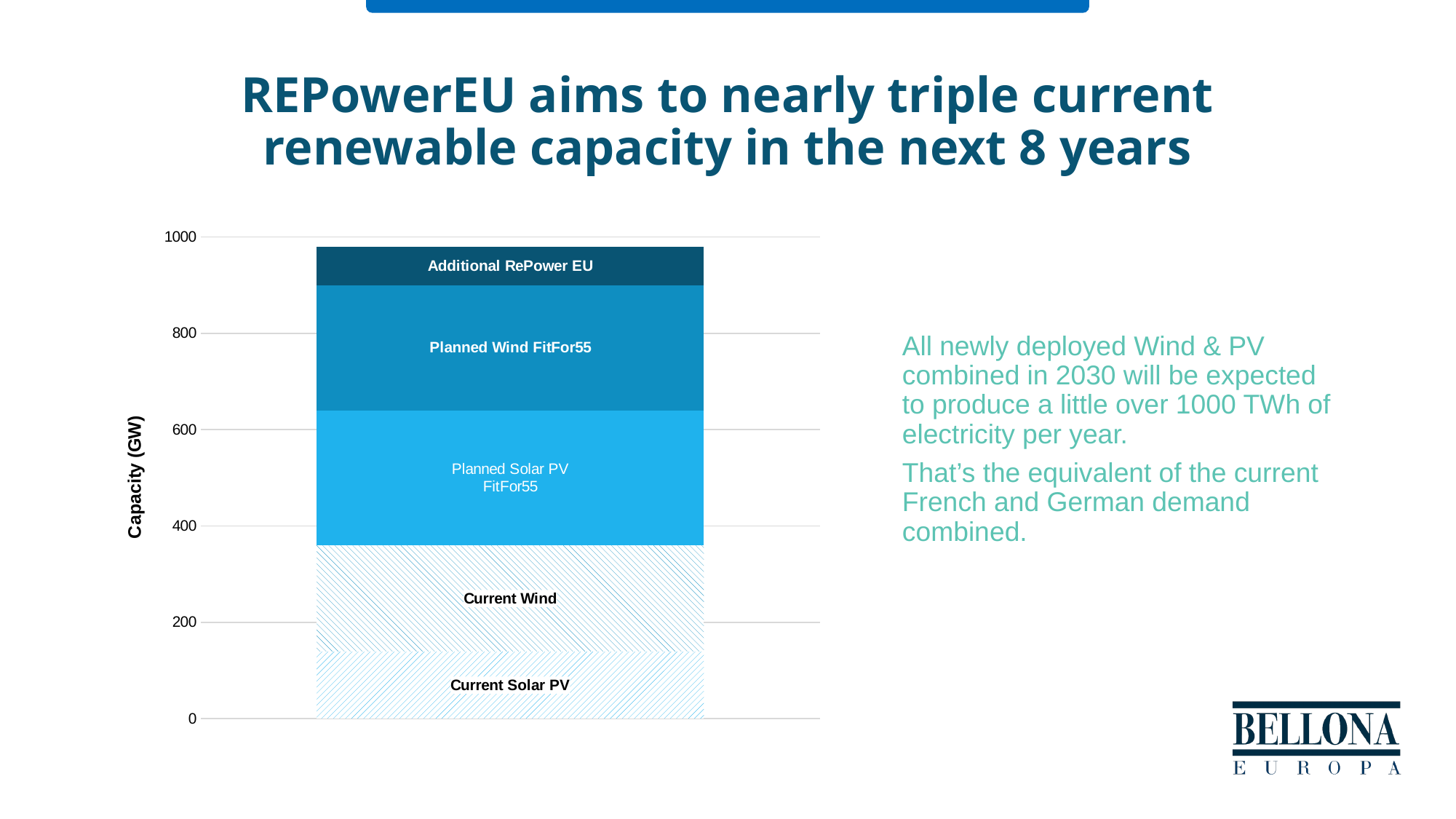
Which is larger, the Current Wind segment or the Current Solar PV segment? Current Wind Which is larger, the Planned Solar PV FitFor55 segment or the Additional RePower EU segment? Planned Solar PV FitFor55 What is the label of the vertical axis? Capacity (GW) Is the combined capacity of Current Solar PV and Current Wind greater or less than 400? less Which segment is at the top of the stacked bar? Additional RePower EU What kind of chart is shown on the slide? Stacked bar chart Which segment is at the bottom of the stacked bar? Current Solar PV How many segments make up the stacked bar? 5 Is the total height of the stacked bar greater or less than 800? greater Which segment of the stacked bar is the smallest? Additional RePower EU Is the total height of the stacked bar greater or less than 1000? less What is the highest tick value shown on the vertical axis? 1000